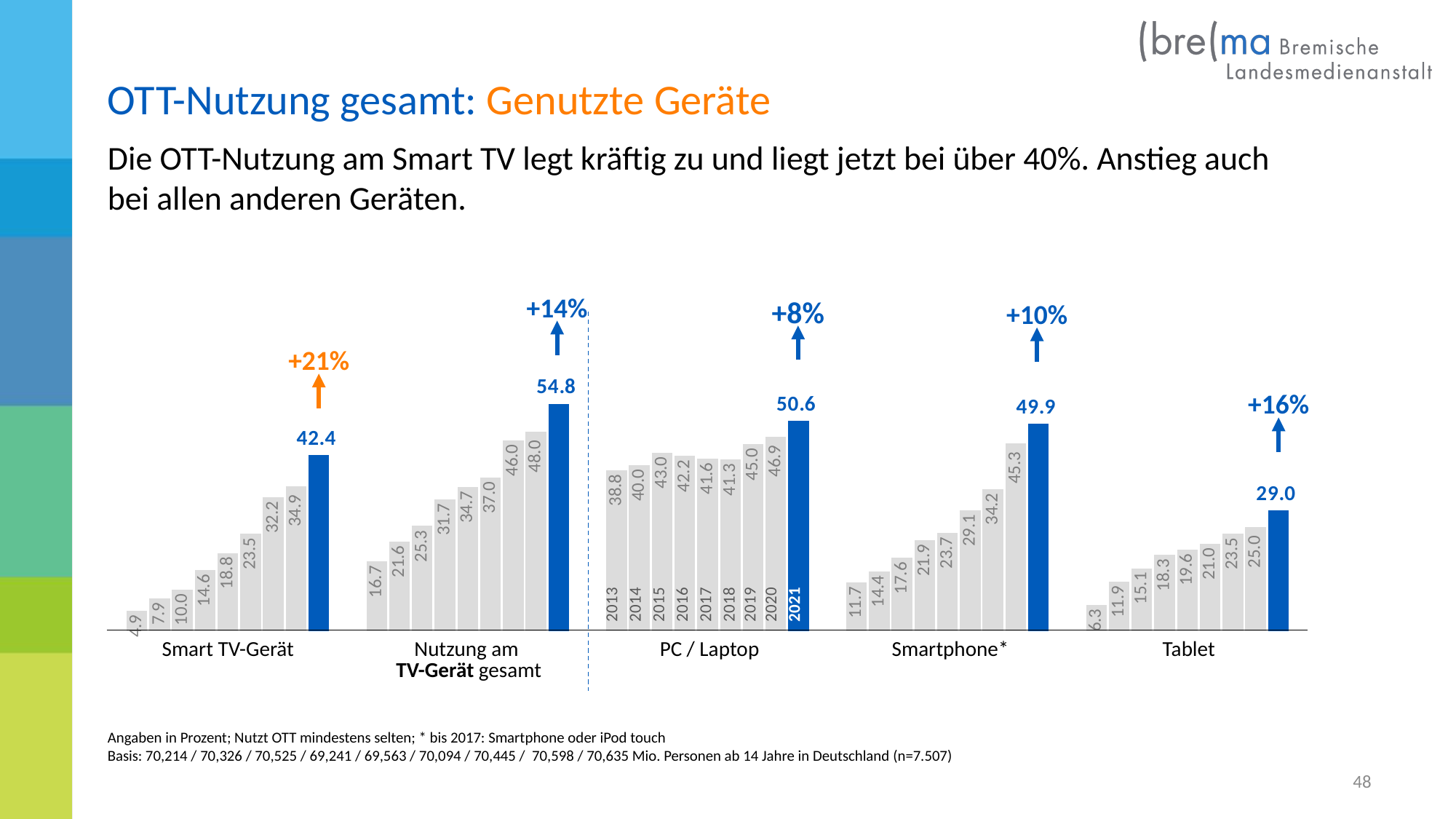
What is the 2021 value for Tablet? 29.0 How many years (bars) are shown for each device group? 9 Which device group has the highest 2021 value? Nutzung am TV-Gerät gesamt What percentage change is shown above the Smart TV-Gerät group? +21% What is the 2021 value for Smart TV-Gerät? 42.4 What kind of chart is shown on the slide? Bar chart What is the 2021 value for Nutzung am TV-Gerät gesamt? 54.8 Which device group has the lowest 2021 value? Tablet What is the difference between the 2021 values for PC / Laptop and Smartphone*? 0.7 What is the 2013 value for PC / Laptop? 38.8 Do the values for Smart TV-Gerät rise or fall from 2013 to 2021? Rise Which is larger in 2021: Smart TV-Gerät or Smartphone*? Smartphone*